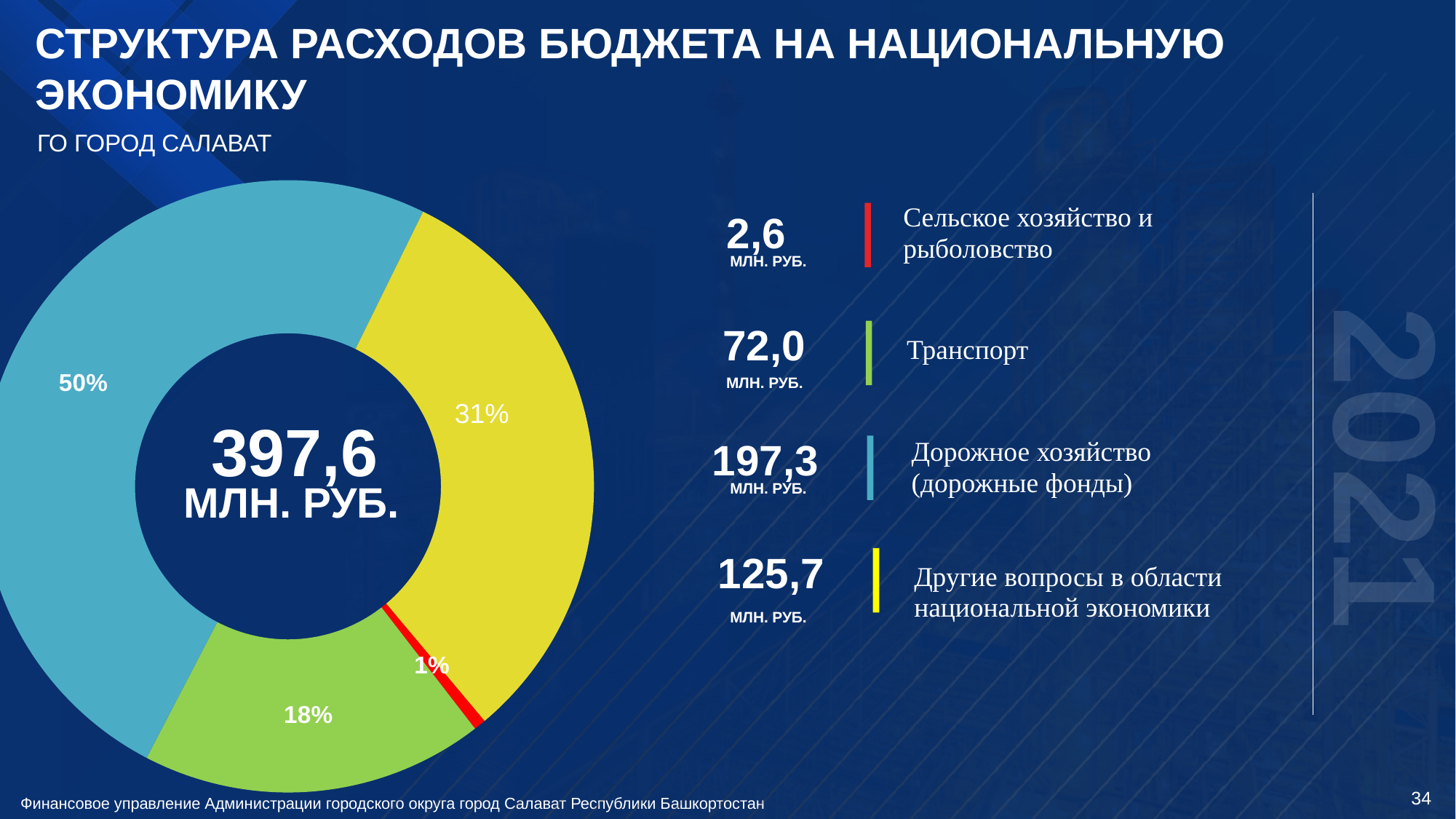
What share of the chart does the yellow slice (Другие вопросы в области национальной экономики) represent? 31% What is the value shown for Транспорт? 72,0 млн. руб. What kind of chart is shown on the slide? Donut (pie) chart Which category has the largest share of the chart? Дорожное хозяйство (дорожные фонды) What total value is shown in the centre of the donut chart? 397,6 млн. руб. What is the value shown for Дорожное хозяйство (дорожные фонды)? 197,3 млн. руб. Which category has the smallest share of the chart? Сельское хозяйство и рыболовство Which is larger: the share for Транспорт or the share for Другие вопросы в области национальной экономики? Другие вопросы в области национальной экономики What share of the chart does the green slice (Транспорт) represent? 18% What share of the chart does the teal slice (Дорожное хозяйство (дорожные фонды)) represent? 50% How many slices does the donut chart have? 4